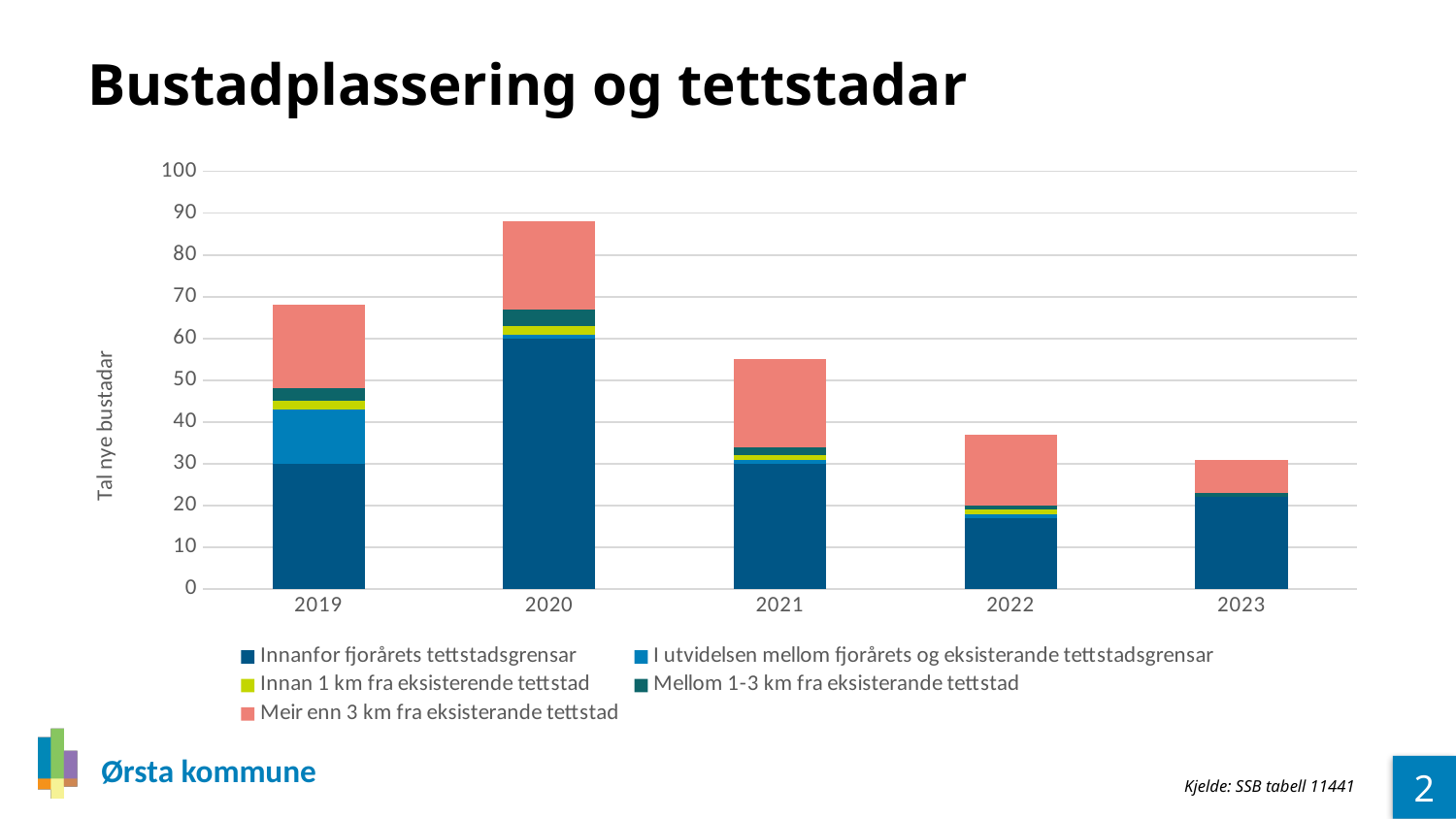
Which year has the larger total, 2019 or 2021? 2019 Which year has the lowest total number of new dwellings? 2023 What is the title of the y axis? Tal nye bustadar How many years are shown on the x axis of the chart? 5 Is the total for 2020 greater or less than 80? greater Do the total bar heights rise or fall from 2020 to 2023? fall What kind of chart is shown on the slide? Stacked bar chart Is the total for 2022 greater or less than 40? less Is the total for 2021 greater or less than 50? greater Which year has the highest total number of new dwellings? 2020 How many series does the legend list? 5